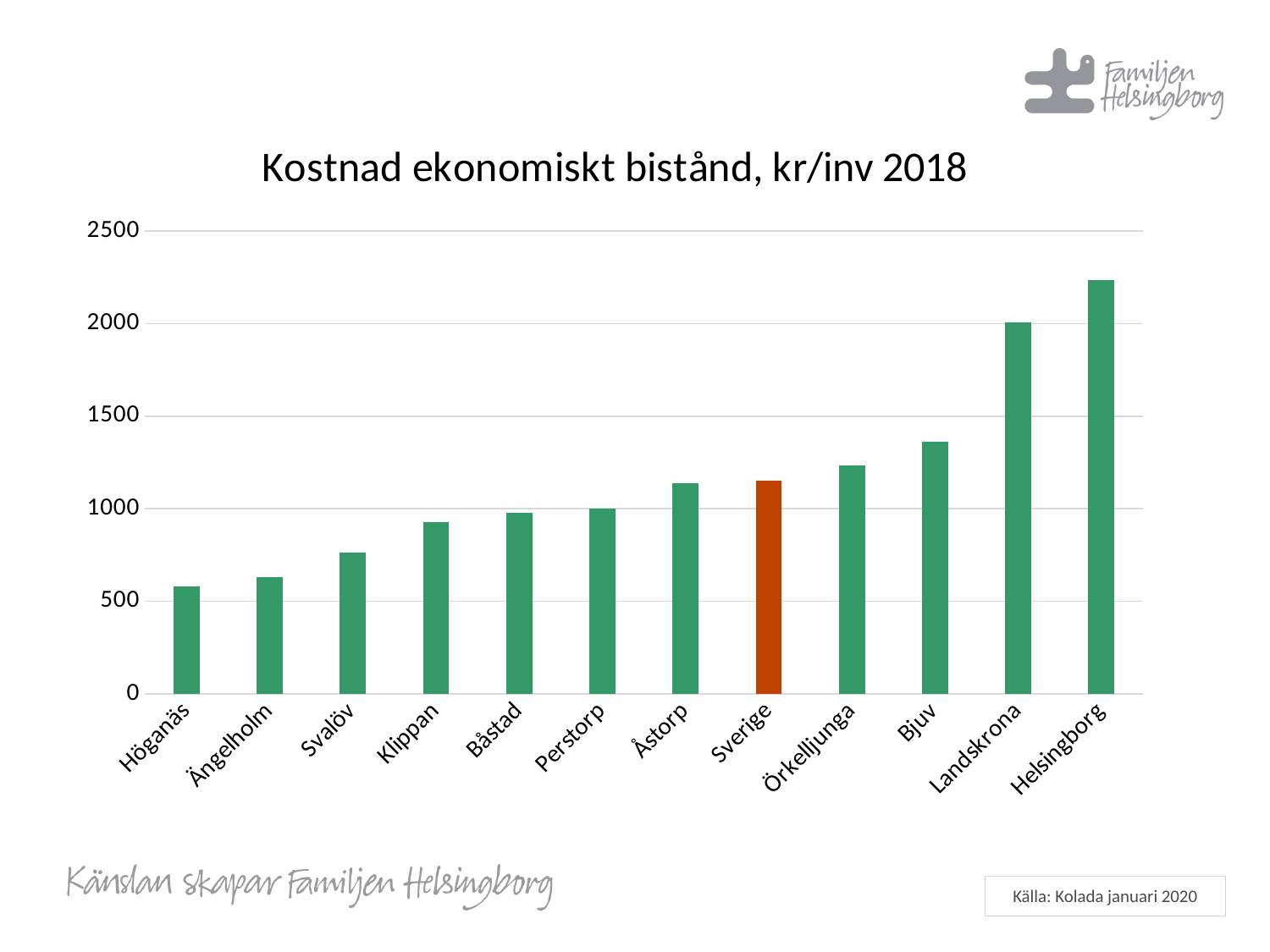
Is the value for Örkelljunga greater or less than 1500? less Is the value for Helsingborg greater or less than 2000? greater Which has a larger value, Landskrona or Helsingborg? Helsingborg What is the title of the chart? Kostnad ekonomiskt bistånd, kr/inv 2018 How many categories are shown on the x axis of the chart? 12 What type of chart is shown on the slide? Bar chart Is the value for Svalöv greater or less than 1000? less Which category has the lowest value in the chart? Höganäs Which category has the highest value in the chart? Helsingborg Which has a larger value, Svalöv or Bjuv? Bjuv Which category's bar is shown in a different colour (orange) from the others? Sverige